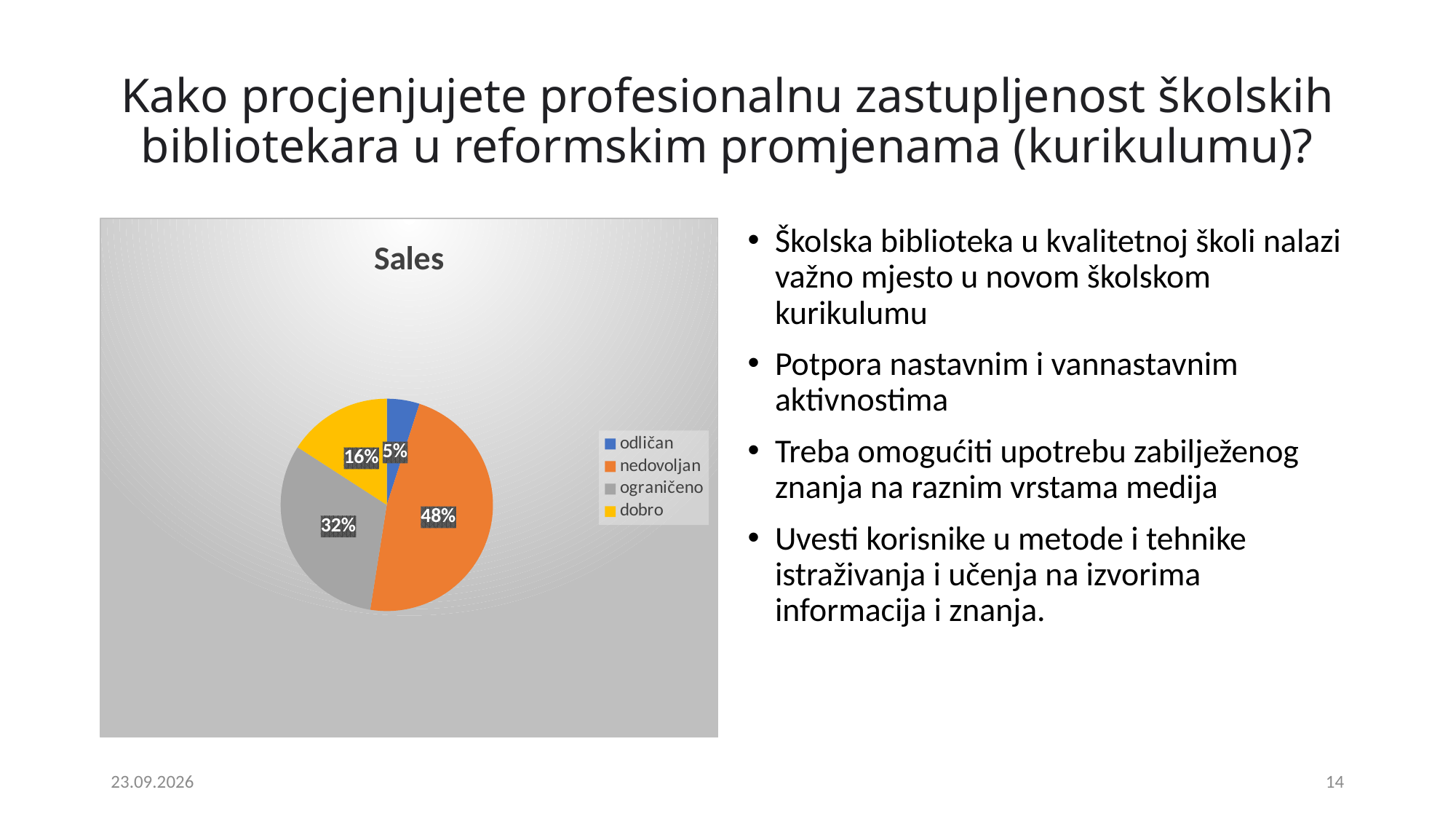
What share of the pie does the 'nedovoljan' slice represent? 48% What is the difference in percentage points between the 'nedovoljan' and 'ograničeno' slices? 16 What share of the pie does the 'odličan' slice represent? 5% What is the title of the chart? Sales What colour is the 'dobro' slice in the pie chart? yellow Which category has the smallest slice of the pie? odličan What kind of chart is shown on the slide? pie chart Which category has the largest slice of the pie? nedovoljan How many categories does the pie chart have? 4 Which slice is larger, 'dobro' or 'ograničeno'? ograničeno What share of the pie does the 'dobro' slice represent? 16%